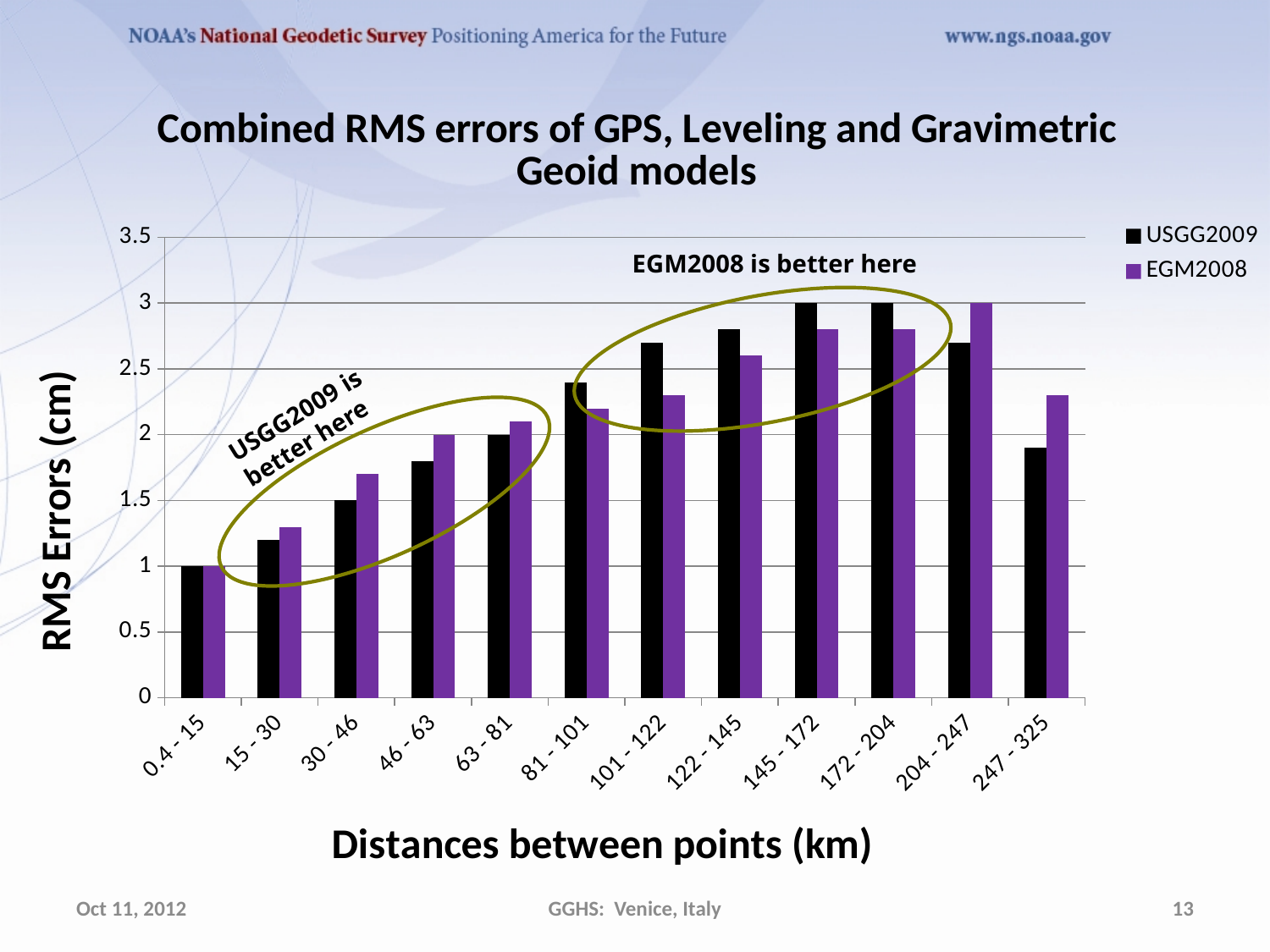
For the 247 - 325 km range, which series has the larger RMS error, USGG2009 or EGM2008? EGM2008 What is the USGG2009 RMS error for the 30 - 46 km distance range? 1.5 What kind of chart is shown on the slide? bar chart Is the USGG2009 value for 122 - 145 km greater or less than 2.5? greater What is the label of the y axis? RMS Errors (cm) What is the USGG2009 RMS error for the 0.4 - 15 km distance range? 1 What is the USGG2009 RMS error for the 145 - 172 km distance range? 3 For the 172 - 204 km range, which series has the larger RMS error, USGG2009 or EGM2008? USGG2009 How many series does the legend list? 2 Is the EGM2008 value for 101 - 122 km greater or less than 2.5? less How many distance categories are shown on the x axis? 12 What is the EGM2008 RMS error for the 204 - 247 km distance range? 3